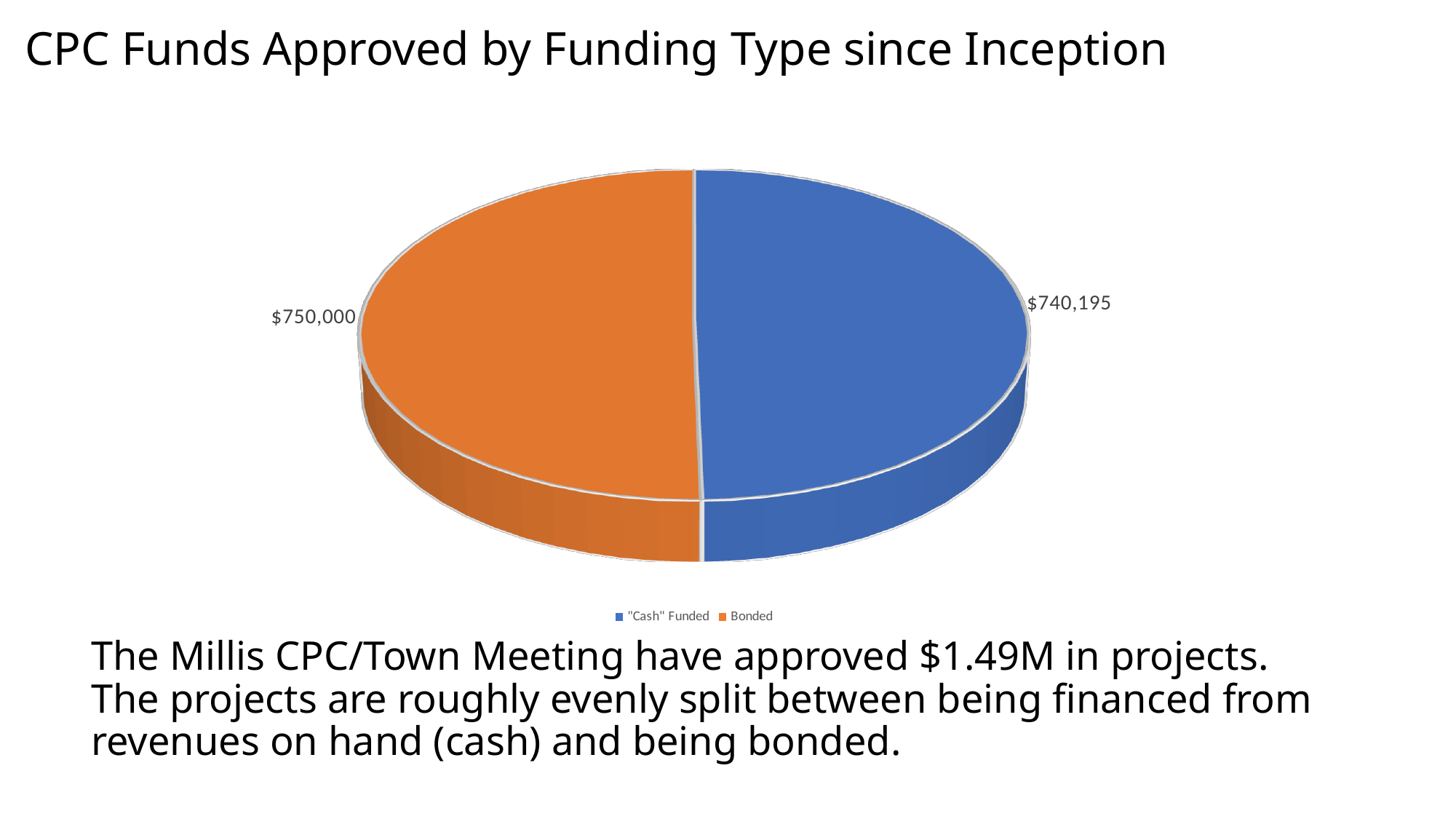
What type of chart is shown on the slide? Pie chart What is the value of the Bonded slice? $750,000 Which funding type has the largest value in the pie chart? Bonded What is the title of the chart? CPC Funds Approved by Funding Type since Inception What is the total of the two slices in the pie chart? $1,490,195 How many slices does the pie chart have? 2 How many entries does the legend list? 2 Which funding type has the smallest value in the pie chart? "Cash" Funded What is the value of the "Cash" Funded slice? $740,195 What colour is the Bonded slice? Orange What is the difference between the Bonded value and the "Cash" Funded value? $9,805 Which funding type has the larger value, "Cash" Funded or Bonded? Bonded